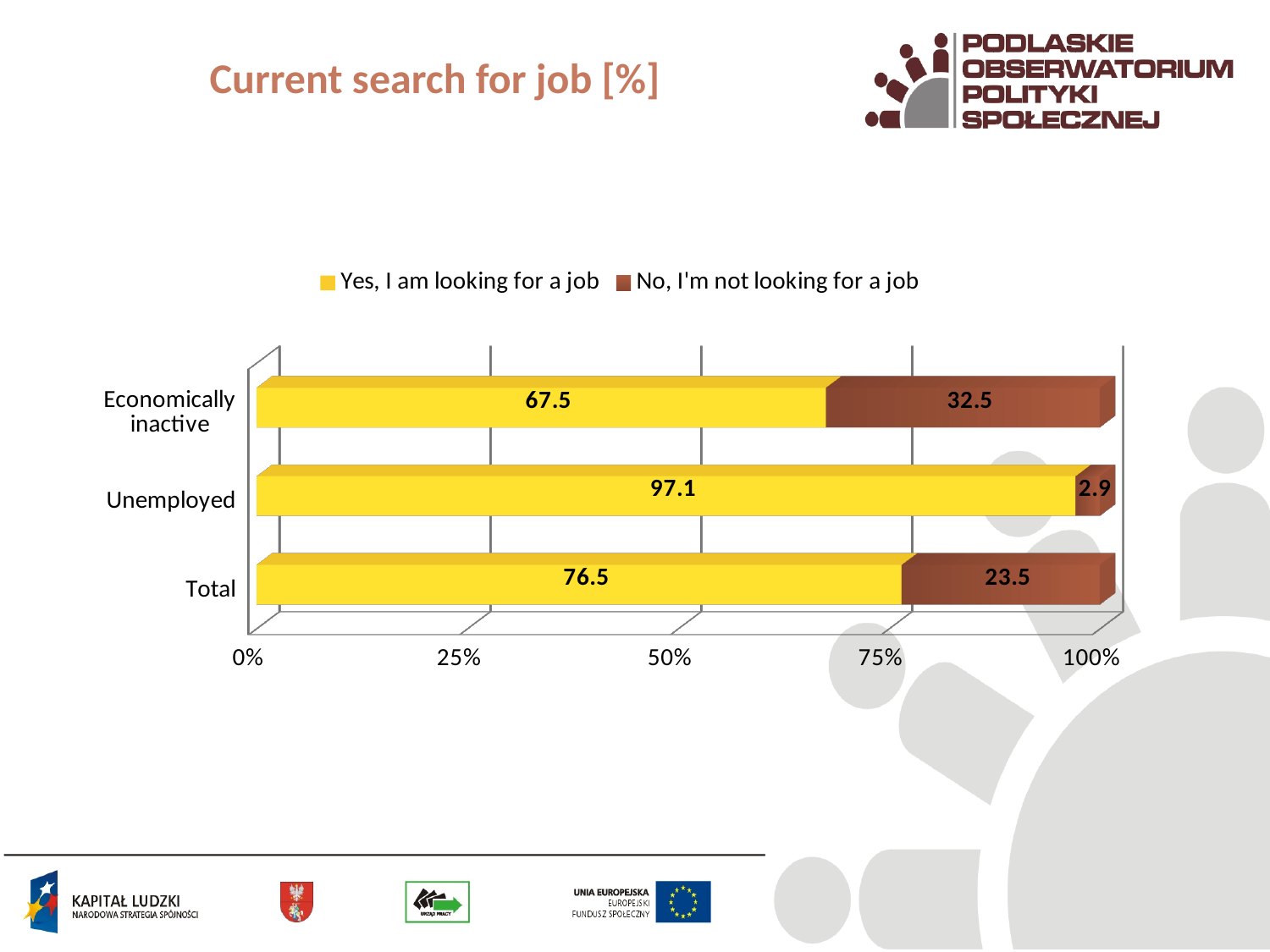
How many categories are shown on the y axis? 3 What is the value for "Yes, I am looking for a job" in the Unemployed category? 97.1 Which category has the lowest value for "No, I'm not looking for a job"? Unemployed What is the title of the chart? Current search for job [%] What is the total of the stacked bar for the Total category? 100 How many series does the legend list? 2 What kind of chart is shown on the slide? Stacked bar chart What is the value for "Yes, I am looking for a job" in the Total category? 76.5 What is the value for "No, I'm not looking for a job" in the Economically inactive category? 32.5 Which is larger: the "No, I'm not looking for a job" value for Economically inactive or for Total? Economically inactive What is the difference between the "Yes, I am looking for a job" values for Unemployed and Economically inactive? 29.6 Which category has the highest value for "Yes, I am looking for a job"? Unemployed